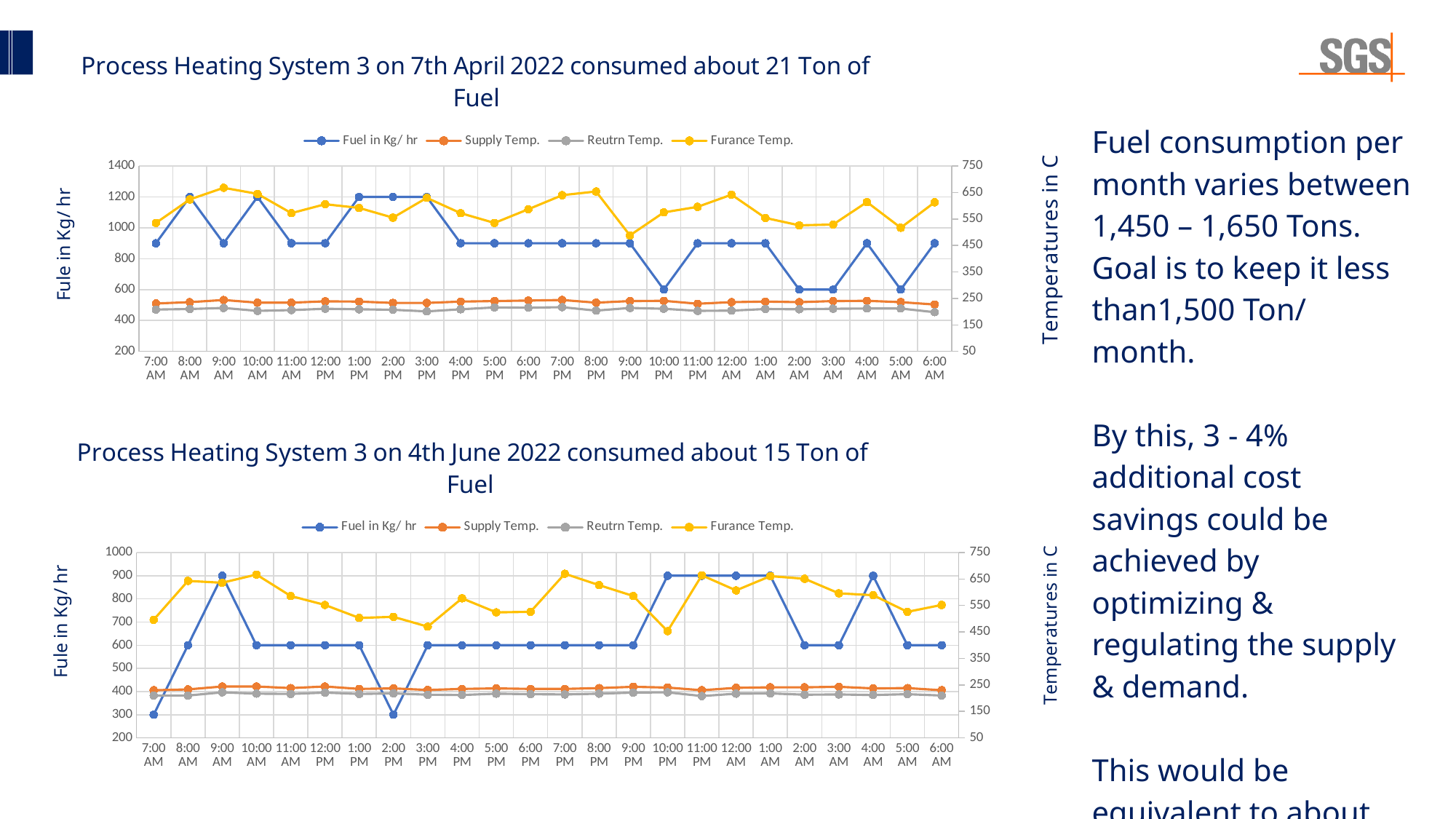
How many time points are plotted along the x axis of the top chart (7th April 2022)? 24 In the bottom chart (4th June 2022), what is the difference between Fuel in Kg/hr at 9:00 AM and at 7:00 AM? 600 In the bottom chart (4th June 2022), which is larger: Fuel in Kg/hr at 9:00 AM or at 10:00 AM? 9:00 AM In the top chart (7th April 2022), is the Furance Temp. value at 9:00 AM greater or less than 600? greater What is the title of the bottom chart on the slide? Process Heating System 3 on 4th June 2022 consumed about 15 Ton of Fuel In the bottom chart (4th June 2022), what is the value of Fuel in Kg/hr at 7:00 AM? 300 In the bottom chart (4th June 2022), is the Furance Temp. value at 10:00 PM greater or less than 500? less In the bottom chart (4th June 2022), what is the value of Fuel in Kg/hr at 2:00 PM? 300 In the top chart (7th April 2022), what is the value of Fuel in Kg/hr at 10:00 PM? 600 What kind of chart is the top chart, 'Process Heating System 3 on 7th April 2022 consumed about 21 Ton of Fuel'? Line chart How many series does the legend of the bottom chart (4th June 2022) list? 4 In the bottom chart (4th June 2022), does Fuel in Kg/hr rise or fall from 7:00 AM to 9:00 AM? Rise